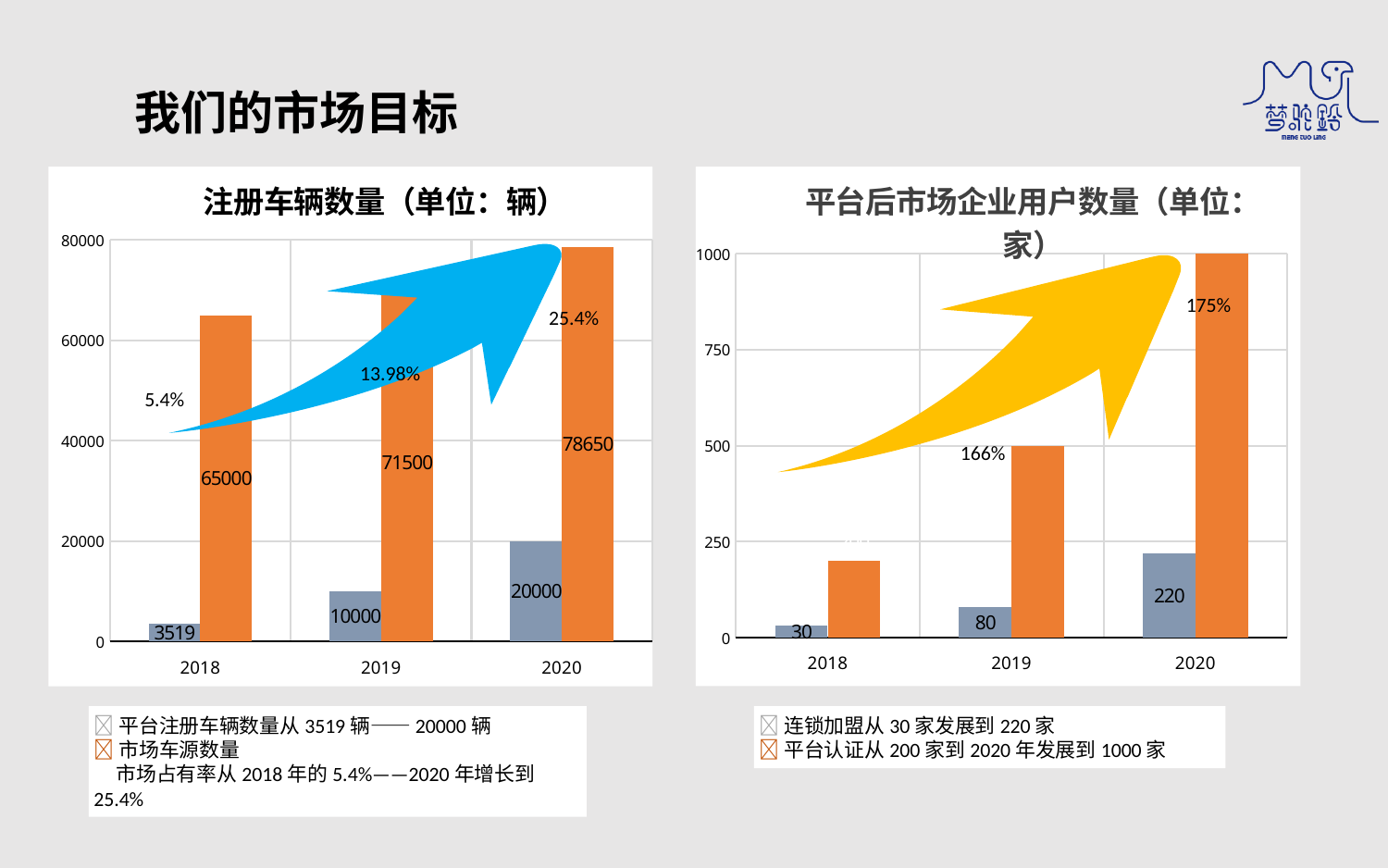
In the right chart (平台后市场企业用户数量), is the orange bar for 2019 greater or less than 250? greater In the left chart (注册车辆数量), do the blue-gray bars rise or fall from 2018 to 2020? rise In the right chart (平台后市场企业用户数量), which year has the larger orange bar, 2019 or 2020? 2020 In the left chart (注册车辆数量), what is the value of the orange bar for 2020? 78650 In the left chart (注册车辆数量), what percentage label is shown above the 2019 bars? 13.98% What kind of chart is the left chart (注册车辆数量)? bar chart In the left chart (注册车辆数量), which year has the highest blue-gray bar? 2020 In the left chart (注册车辆数量), what is the value of the blue-gray bar for 2018? 3519 How many years are shown on the x axis of the left chart (注册车辆数量)? 3 In the right chart (平台后市场企业用户数量), what is the difference between the blue-gray bar values for 2020 and 2019? 140 In the right chart (平台后市场企业用户数量), what is the value of the blue-gray bar for 2020? 220 In the left chart (注册车辆数量), what is the difference between the orange bar values for 2020 and 2018? 13650